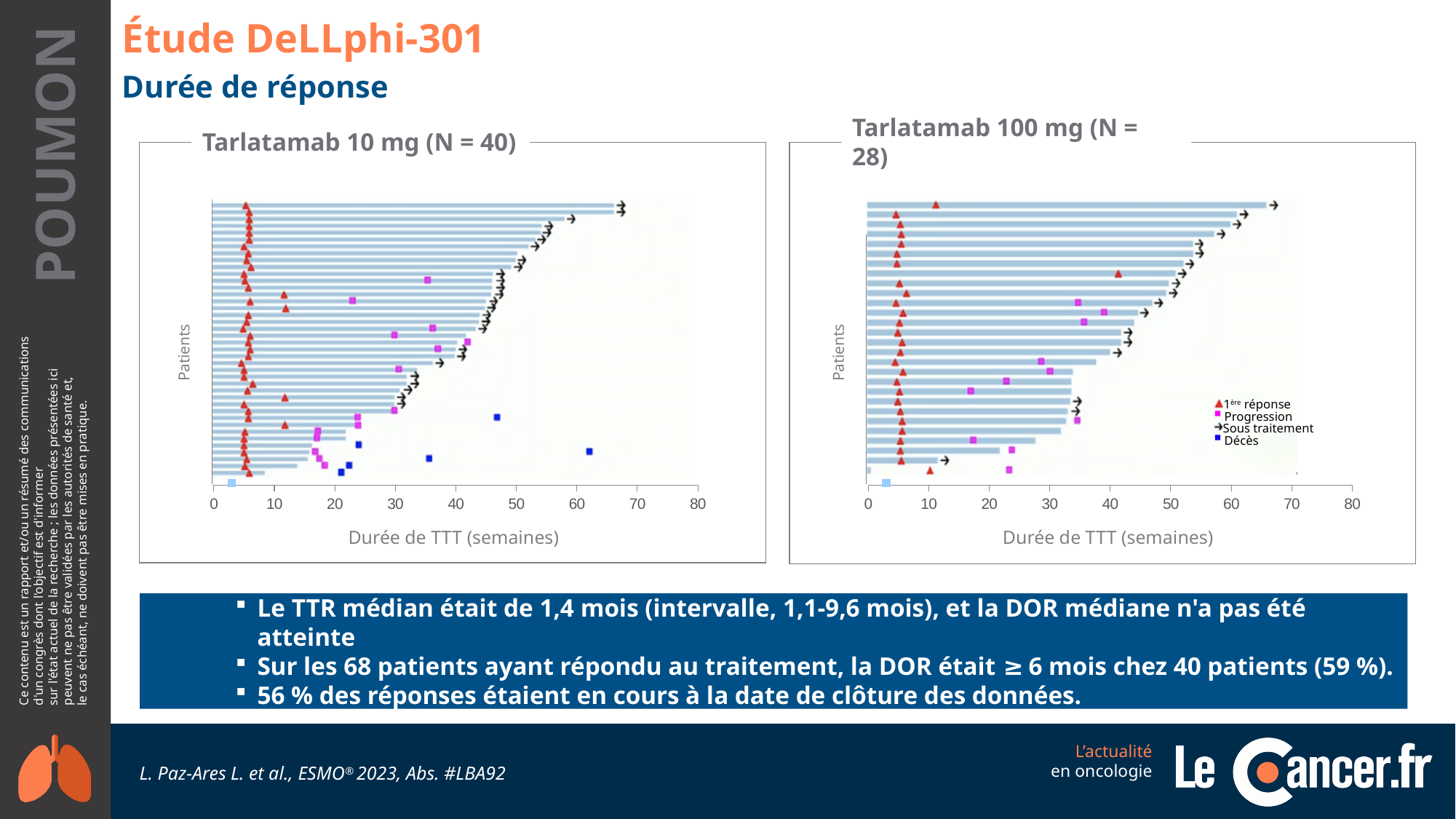
In the Tarlatamab 10 mg chart, is the duration of the longest bar greater or less than 60 weeks? greater How many patients are shown in the Tarlatamab 10 mg chart, according to its title? 40 How many patients are shown in the Tarlatamab 100 mg chart, according to its title? 28 Which chart includes more patients, Tarlatamab 10 mg or Tarlatamab 100 mg? Tarlatamab 10 mg In the Tarlatamab 10 mg chart, is the duration of the shortest bar greater or less than 10 weeks? less What is the maximum value shown on the x axis of the Tarlatamab 100 mg chart? 80 What kind of chart is the Tarlatamab 10 mg (N = 40) chart? bar chart In the Tarlatamab 100 mg chart, is the duration of the longest bar greater or less than 60 weeks? greater How many entries does the legend on the Tarlatamab 100 mg chart list? 4 What is the x-axis label of the Tarlatamab 10 mg chart? Durée de TTT (semaines) How many more patients are in the Tarlatamab 10 mg chart than in the Tarlatamab 100 mg chart? 12